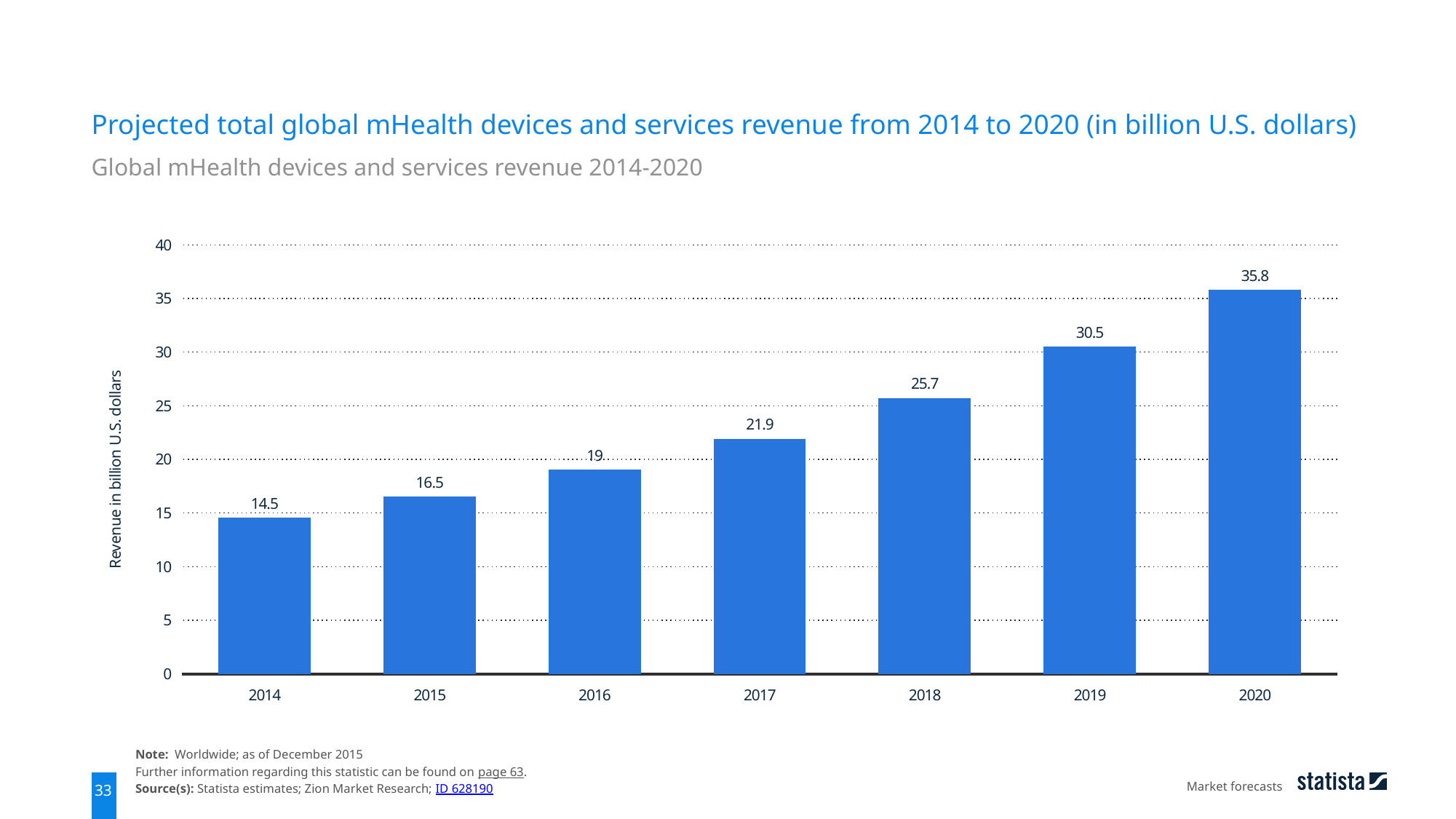
What is the difference in projected revenue between 2019 and 2018? 4.8 What is the projected global mHealth devices and services revenue for 2017? 21.9 How many years are shown on the x axis of the chart? 7 What is the projected global mHealth devices and services revenue for 2020? 35.8 What kind of chart is shown on the slide? Bar chart Which year has the highest projected mHealth devices and services revenue? 2020 Which year has the lowest projected mHealth devices and services revenue? 2014 What is the projected global mHealth devices and services revenue for 2014? 14.5 Is the projected revenue for 2019 greater or less than 30? greater Do the projected revenue values rise or fall from 2014 to 2020? Rise What is the difference in projected revenue between 2020 and 2014? 21.3 Which year has a higher projected revenue, 2016 or 2018? 2018